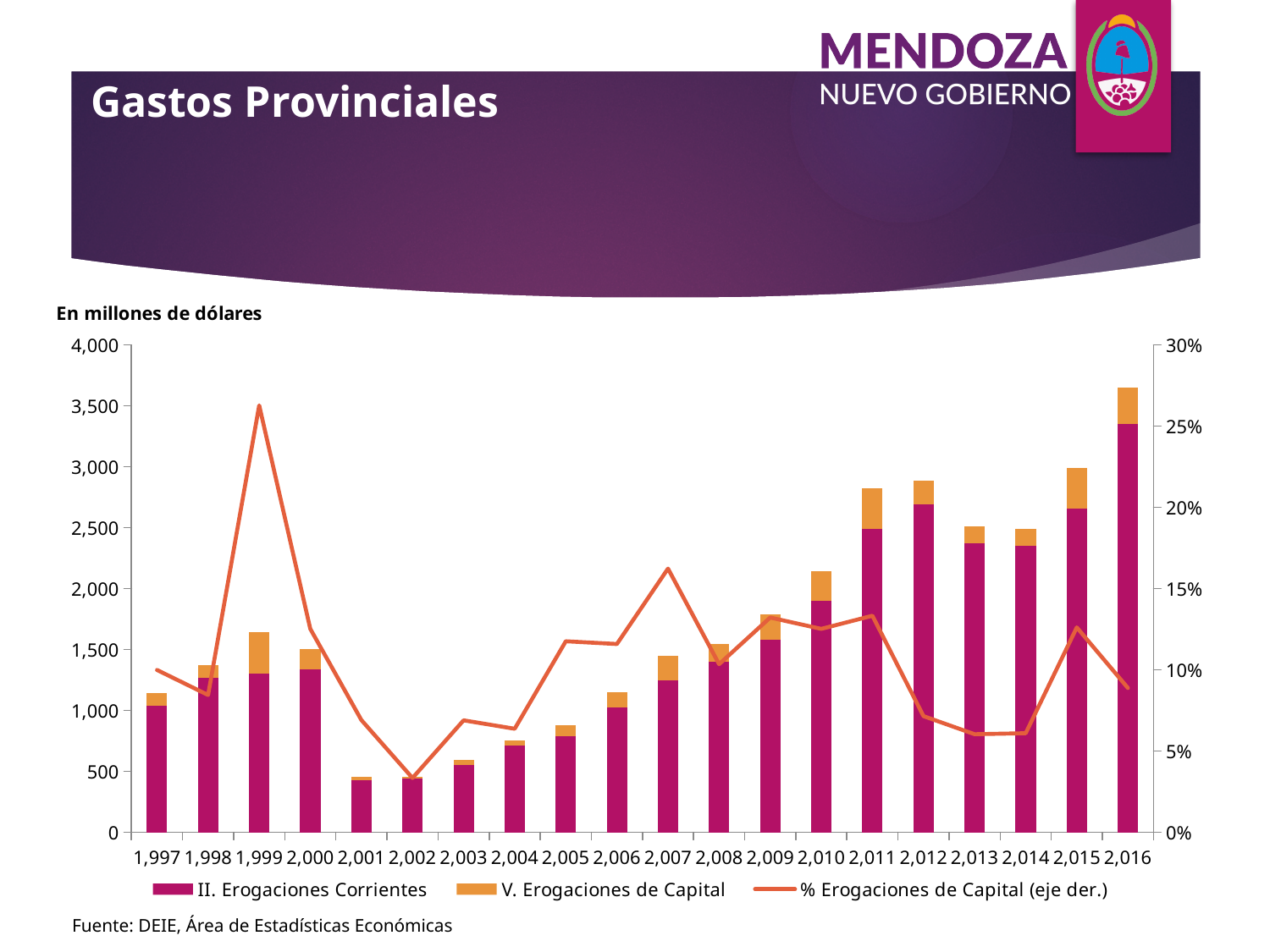
How many years are shown along the x axis of the chart? 20 Is the value of '% Erogaciones de Capital (eje der.)' in 1,999 greater or less than 25%? greater Is the total bar for 2,002 greater or less than 500? less What unit is stated above the chart for the bar values? En millones de dólares Which year has the larger total bar, 2,014 or 2,015? 2,015 Is the value of '% Erogaciones de Capital (eje der.)' in 2,012 greater or less than 10%? less How many series does the chart legend list? 3 What kind of chart is shown on the slide? A combined stacked bar and line chart Which year has the highest total bar (Erogaciones Corrientes plus Erogaciones de Capital)? 2,016 In which year does the line '% Erogaciones de Capital (eje der.)' reach its highest value? 1,999 Does the line '% Erogaciones de Capital (eje der.)' rise or fall from 2,011 to 2,013? fall